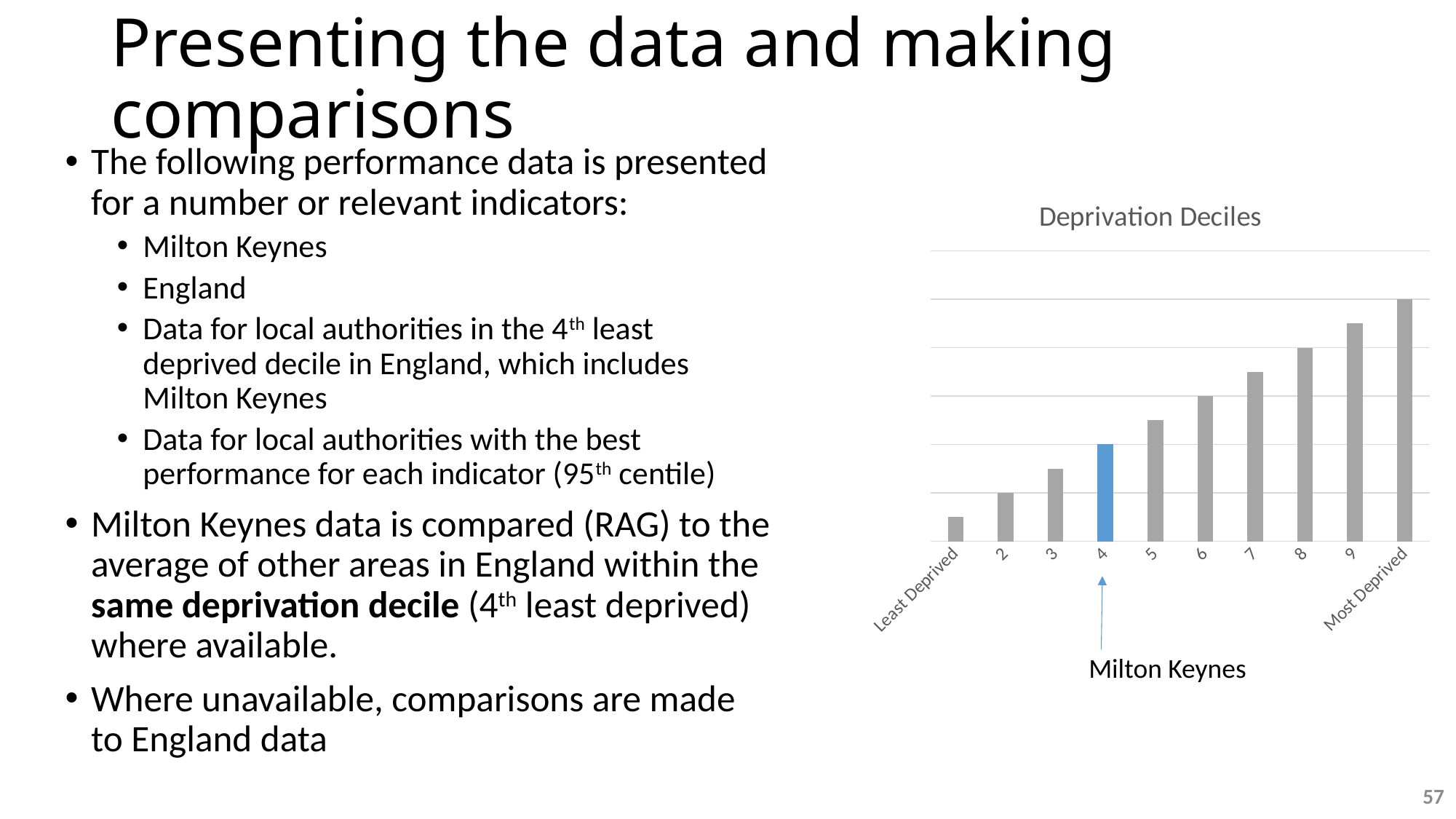
In the Deprivation Deciles chart, which bar is taller: decile 2 or decile 5? 5 How many bars does the Deprivation Deciles chart have? 10 Which decile in the Deprivation Deciles chart is labelled with the arrow as Milton Keynes? 4 Do the bars in the Deprivation Deciles chart rise or fall from left to right? rise In the Deprivation Deciles chart, which bar is shorter: decile 9 or Most Deprived? 9 Which category has the tallest bar in the Deprivation Deciles chart? Most Deprived What is the title of the chart on the slide? Deprivation Deciles What kind of chart is shown on the slide? bar chart Which category has the shortest bar in the Deprivation Deciles chart? Least Deprived Which decile bar is highlighted in blue in the Deprivation Deciles chart? 4 In the Deprivation Deciles chart, which bar is taller: decile 4 or decile 7? 7